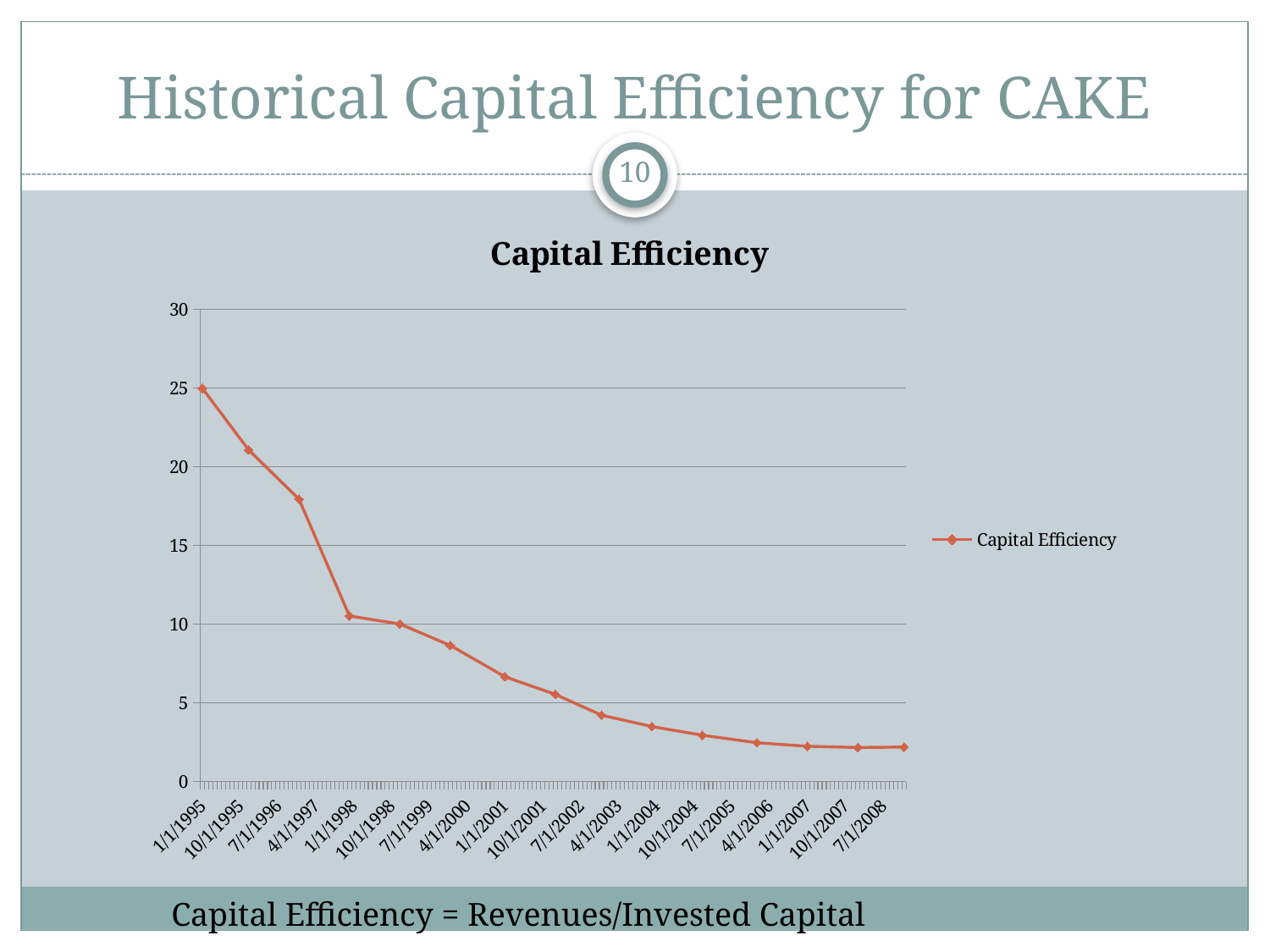
What is the title of the chart? Capital Efficiency At which date on the x axis is Capital Efficiency highest? 1/1/1995 Is the Capital Efficiency value at 7/1/2008 greater or less than 10? less Is the Capital Efficiency value at 7/1/2008 greater or less than 5? less What kind of chart is shown on the slide? line chart Which is larger, the Capital Efficiency value at 1/1/1995 or at 7/1/2008? 1/1/1995 Is the Capital Efficiency value at 1/1/1995 greater or less than 20? greater How many data point markers are plotted on the Capital Efficiency line? 15 Which is larger, the Capital Efficiency value at 10/1/1995 or at 1/1/1998? 10/1/1995 Do the Capital Efficiency values rise or fall from left to right along the x axis? fall How many series does the legend list? 1 What is the name of the series shown in the legend? Capital Efficiency